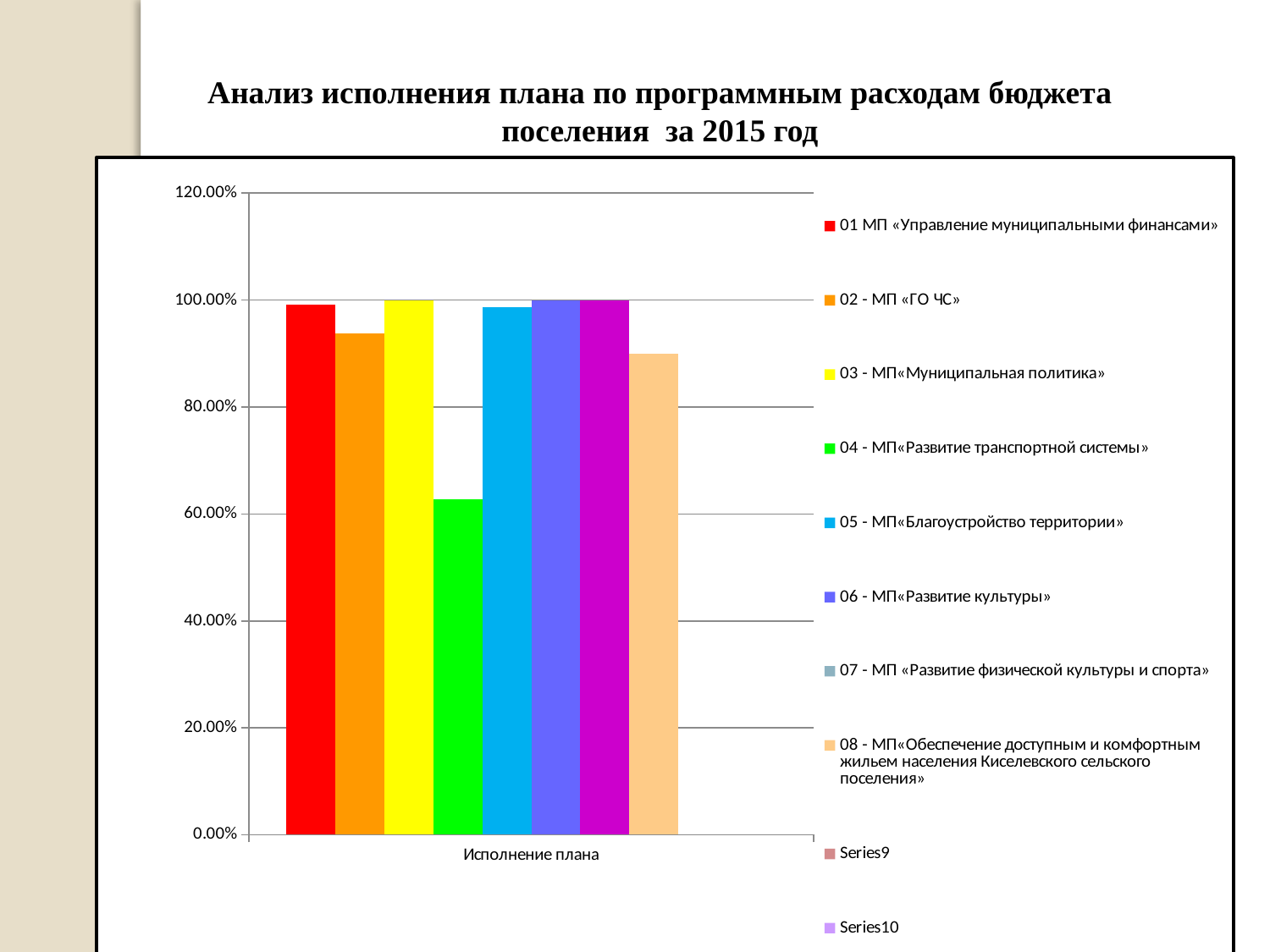
Which is larger, the value for 01 МП «Управление муниципальными финансами» or the value for 08 - МП«Обеспечение доступным и комфортным жильем населения Киселевского сельского поселения»? 01 МП «Управление муниципальными финансами» Is the value for 04 - МП«Развитие транспортной системы» greater or less than 80.00%? less Is the value for 02 - МП «ГО ЧС» greater or less than 80.00%? greater Which is larger, the value for 02 - МП «ГО ЧС» or the value for 04 - МП«Развитие транспортной системы»? 02 - МП «ГО ЧС» What is the title of the slide's chart? Анализ исполнения плана по программным расходам бюджета поселения за 2015 год How many entries does the chart's legend list? 10 Which series has the lowest bar in the chart? 04 - МП«Развитие транспортной системы» What is the label of the single category on the x axis? Исполнение плана Is the value for 01 МП «Управление муниципальными финансами» greater or less than 80.00%? greater What kind of chart is shown on the slide? bar chart How many categories are shown on the x axis of the chart? 1